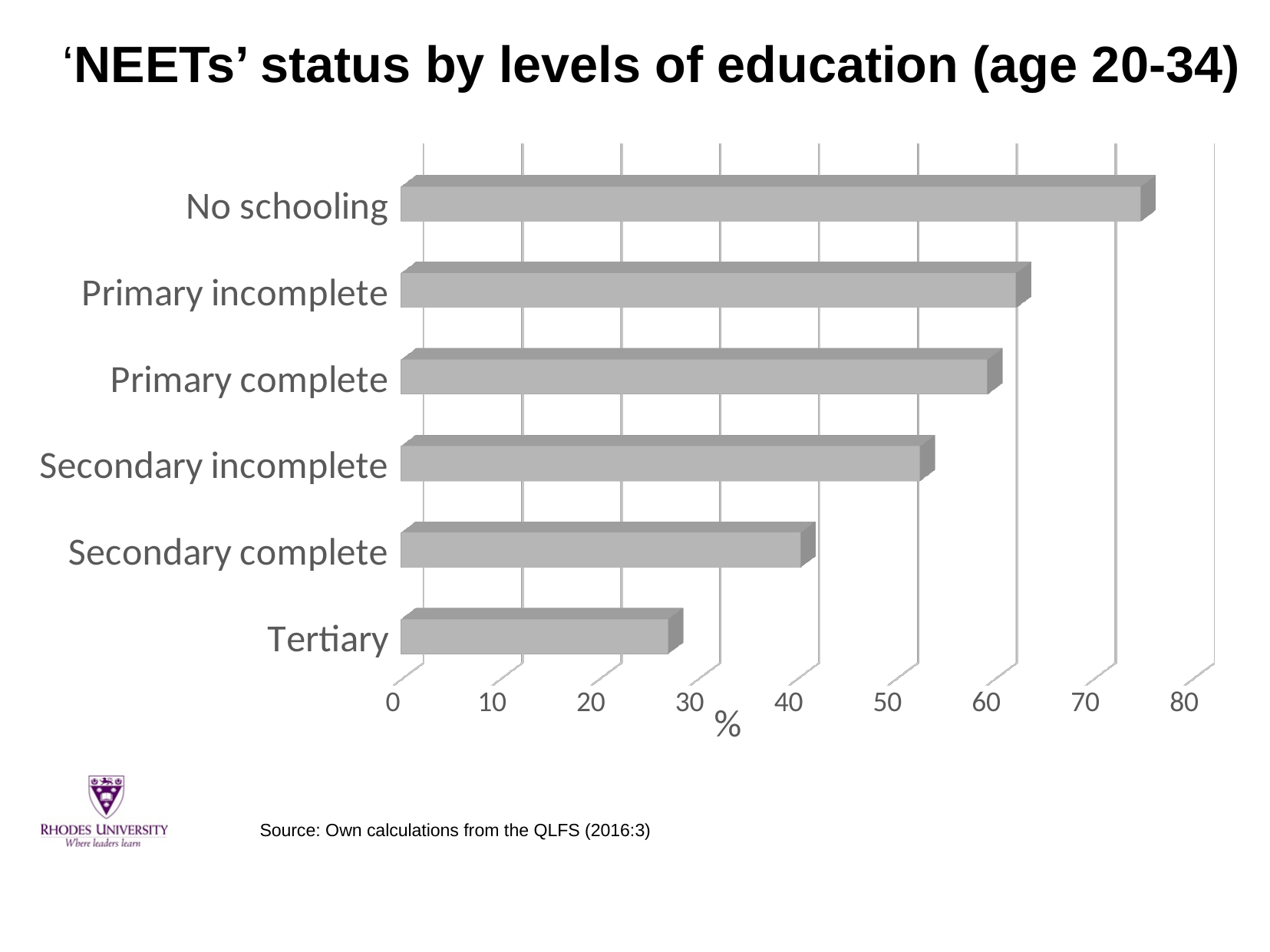
Is the value for Tertiary greater or less than 30? less Which education category has the highest NEET percentage? No schooling What kind of chart is shown on the slide? bar chart Do the NEET percentages rise or fall as the level of education increases from No schooling to Tertiary? fall Is the value for Secondary incomplete greater or less than 60? less Which education category has the lowest NEET percentage? Tertiary Which is larger, the value for Secondary incomplete or the value for Secondary complete? Secondary incomplete How many education categories are plotted in the chart? 6 Is the value for Primary incomplete greater or less than 60? greater What is the label on the horizontal axis of the chart? %